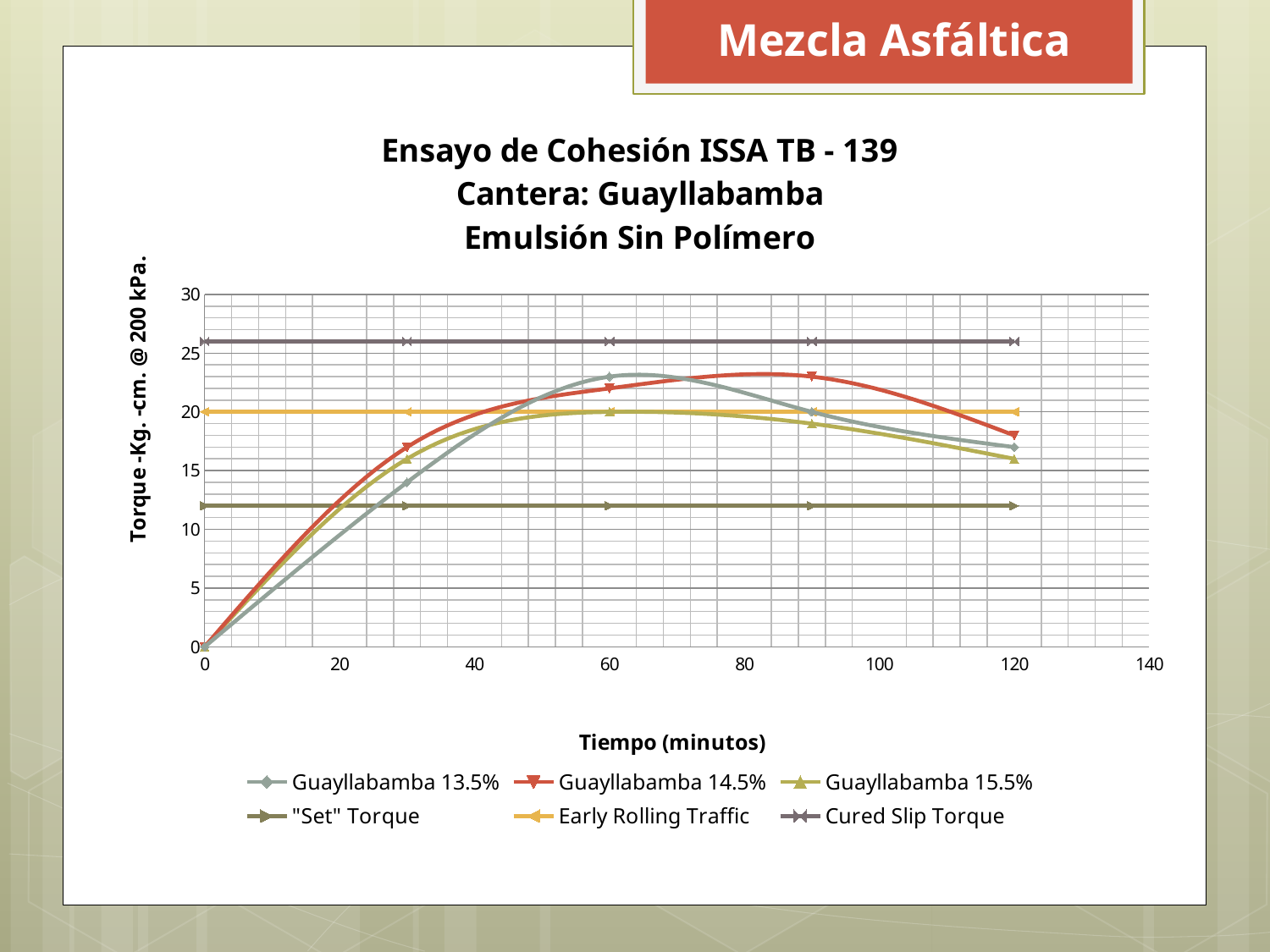
Is the value of the "Set" Torque line greater or less than 10? greater Of the three horizontal reference lines, which has the highest value? Cured Slip Torque How many series does the legend list? 6 Is the value for Guayllabamba 15.5% at 120 minutes greater or less than 20? less What is the title of the x axis? Tiempo (minutos) What kind of chart is shown on the slide? line chart Does the Guayllabamba 13.5% series rise or fall between 0 and 60 minutes? rise What is the torque value of the Guayllabamba 14.5% series at 0 minutes? 0 What is the constant torque value of the Early Rolling Traffic line? 20 Is the value of the Cured Slip Torque line greater or less than 25? greater Does the Guayllabamba 14.5% series rise or fall between 90 and 120 minutes? fall At 120 minutes, which is higher: Guayllabamba 14.5% or Guayllabamba 15.5%? Guayllabamba 14.5%